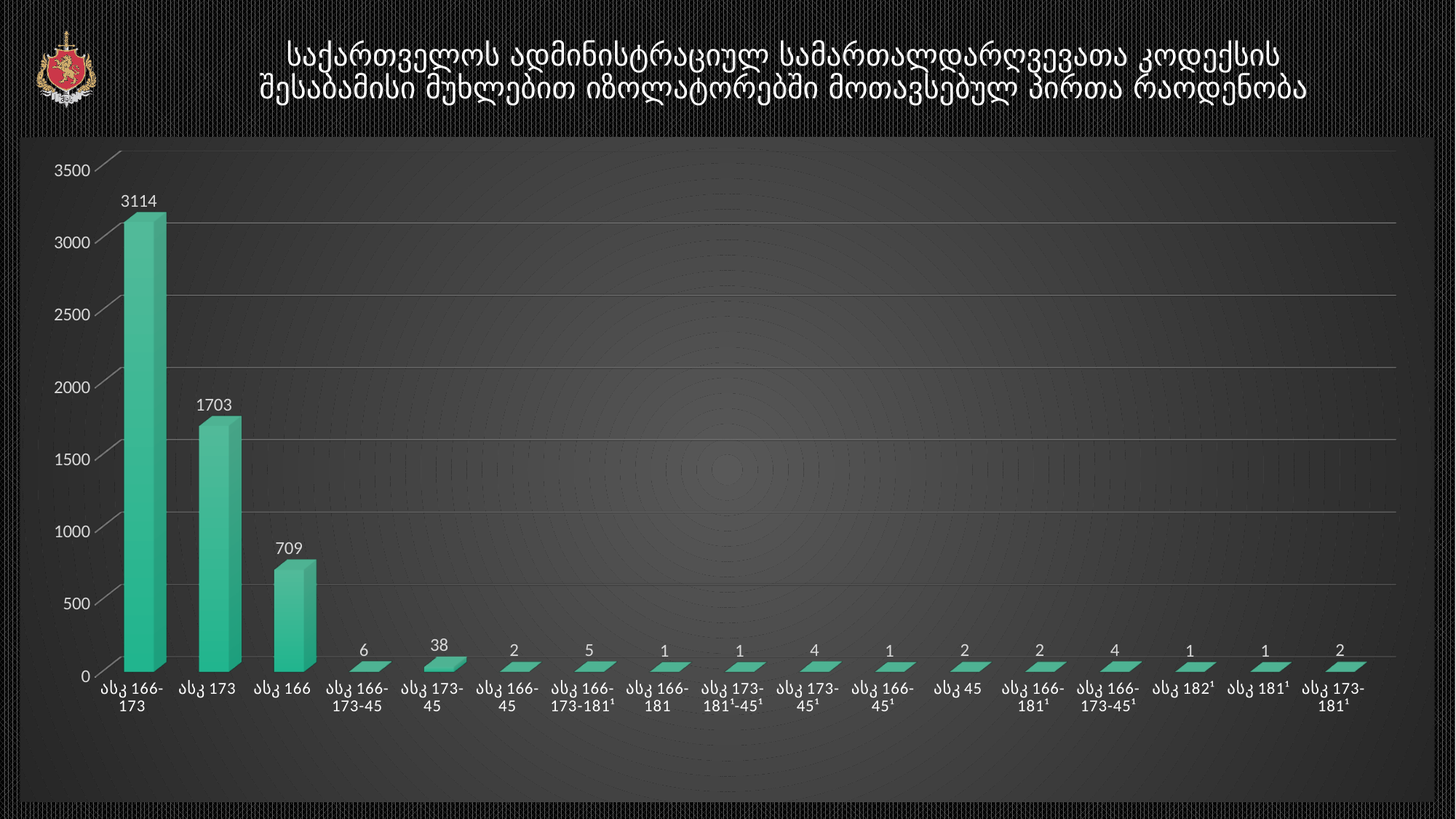
How many categories are shown on the x axis? 17 Is the value for ასკ 166 greater or less than 1000? less What is the value for ასკ 166-173? 3114 What is the difference between the values for ასკ 166-173 and ასკ 173? 1411 What is the difference between the values for ასკ 173 and ასკ 166? 994 What kind of chart is shown on the slide? bar chart Which category has the highest value? ასკ 166-173 What is the value for ასკ 173? 1703 What is the value for ასკ 173-45? 38 Which is larger, the value for ასკ 173-45 or the value for ასკ 166-173-45? ასკ 173-45 What is the value for ასკ 45? 2 What is the value for ასკ 166? 709